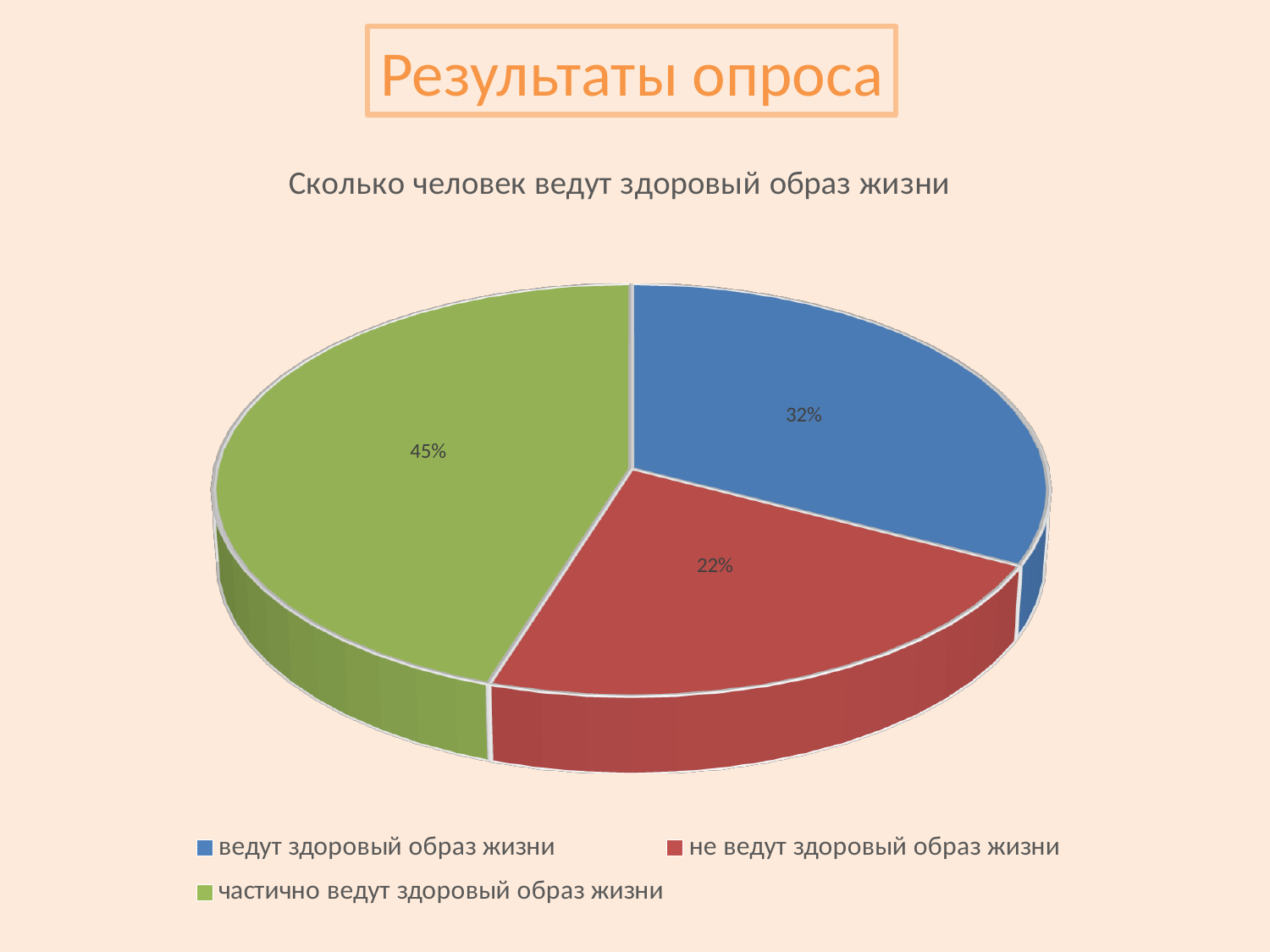
What is the title of the chart? Сколько человек ведут здоровый образ жизни What share of the pie is labelled "частично ведут здоровый образ жизни"? 45% What share of the pie is labelled "не ведут здоровый образ жизни"? 22% Which category has the largest slice of the pie? частично ведут здоровый образ жизни What share of the pie is labelled "ведут здоровый образ жизни"? 32% What is the difference in percentage points between the "ведут здоровый образ жизни" slice and the "не ведут здоровый образ жизни" slice? 10 How many slices does the pie chart have? 3 Which category has the smallest slice of the pie? не ведут здоровый образ жизни What kind of chart is shown on the slide? Pie chart What colour is the slice for "не ведут здоровый образ жизни"? Red What is the difference in percentage points between the "частично ведут здоровый образ жизни" slice and the "ведут здоровый образ жизни" slice? 13 Which slice is larger: "ведут здоровый образ жизни" or "не ведут здоровый образ жизни"? ведут здоровый образ жизни